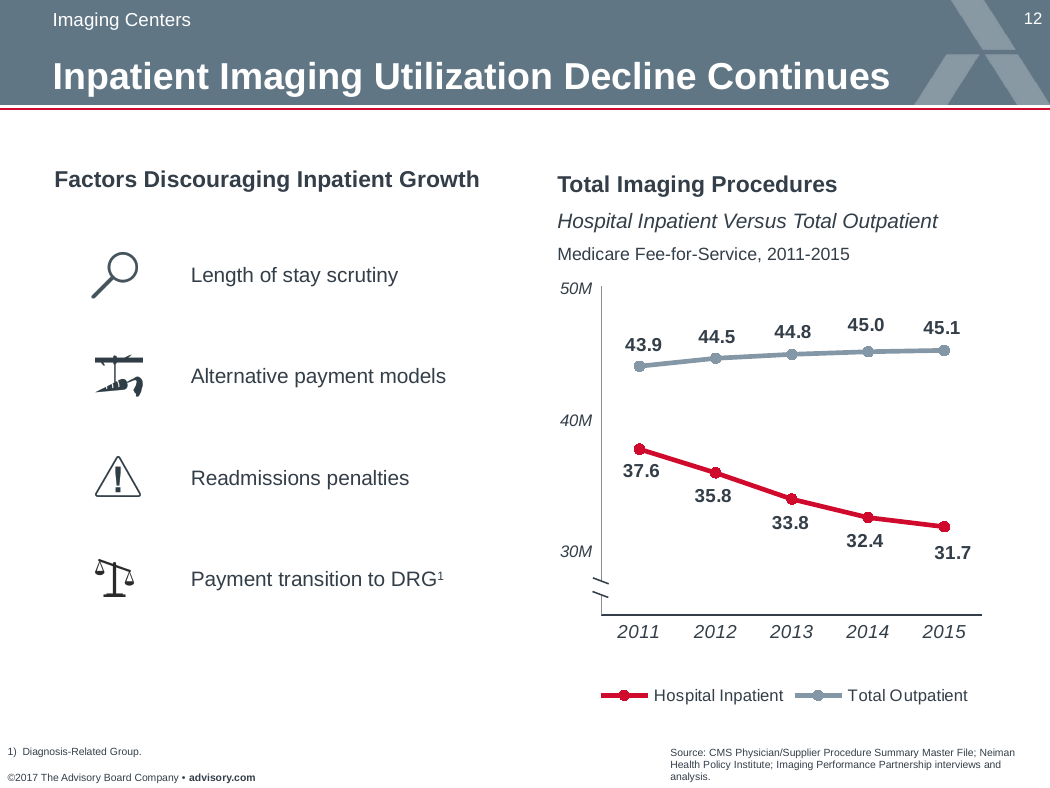
What is the Hospital Inpatient value for 2014? 32.4 What kind of chart is shown on the slide? line chart What is the difference between the Total Outpatient and Hospital Inpatient values in 2015? 13.4 What is the Total Outpatient value for 2015? 45.1 Which series has the larger value in 2013, Hospital Inpatient or Total Outpatient? Total Outpatient Is the Hospital Inpatient value for 2012 greater or less than 40M? less In which year is the Total Outpatient value highest? 2015 How many years are plotted on the x axis? 5 By how much did the Hospital Inpatient value fall from 2011 to 2015? 5.9 What is the Hospital Inpatient value for 2011? 37.6 How many series does the legend list? 2 In which year is the Hospital Inpatient value lowest? 2015